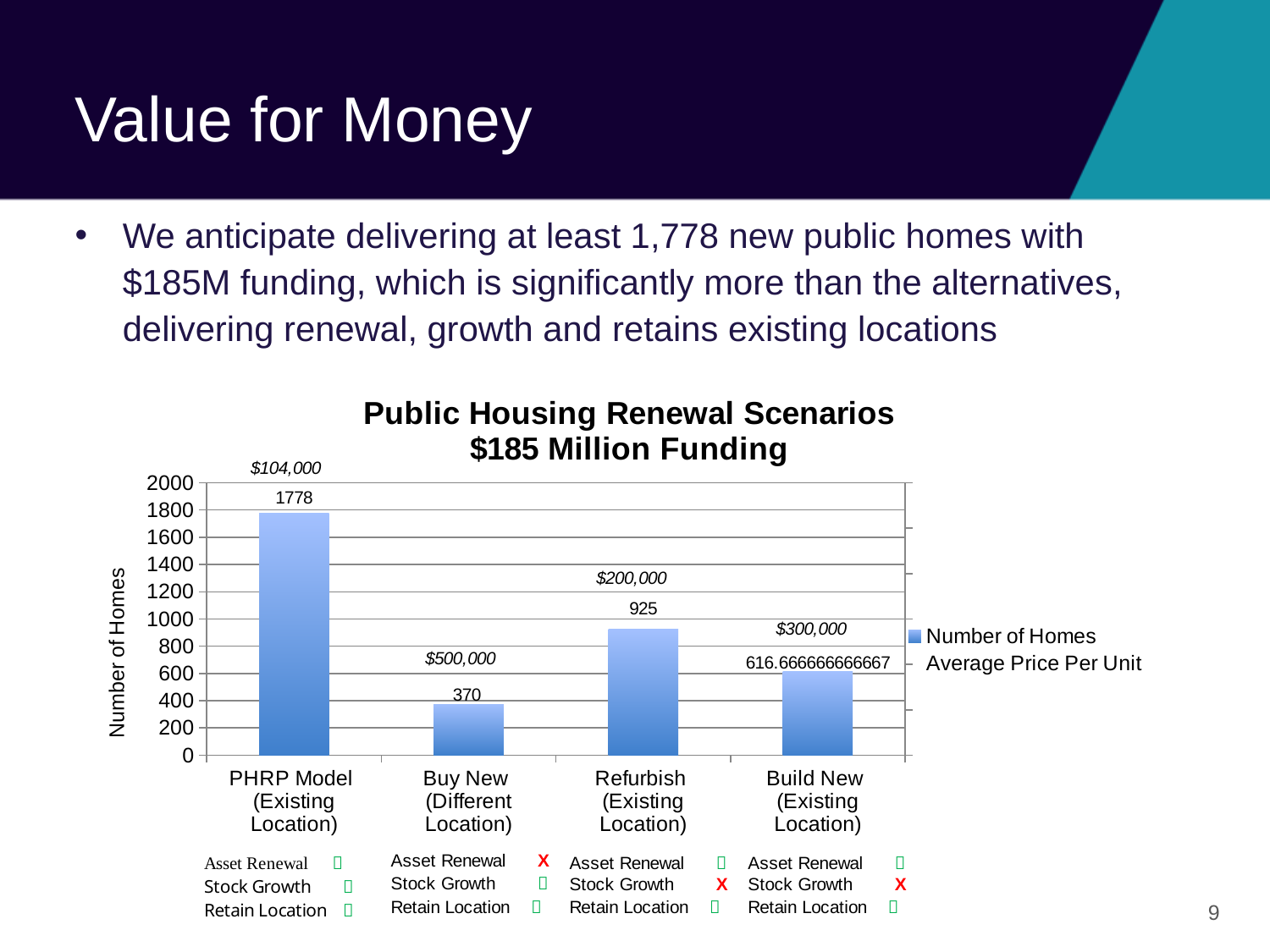
What is the difference in number of homes between the PHRP Model and Refurbish scenarios? 853 Which has more homes, Refurbish (Existing Location) or Buy New (Different Location)? Refurbish (Existing Location) Which scenario has the highest number of homes? PHRP Model (Existing Location) Which scenario has the lowest number of homes? Buy New (Different Location) What is the number of homes for the Refurbish (Existing Location) scenario? 925 What is the number of homes for the Buy New (Different Location) scenario? 370 How many series does the chart legend list? 2 What average price per unit is shown for the PHRP Model (Existing Location) scenario? $104,000 What is the number of homes for the PHRP Model (Existing Location) scenario? 1778 What type of chart is used to show the Public Housing Renewal Scenarios? Bar chart What average price per unit is shown for the Build New (Existing Location) scenario? $300,000 How many scenarios are shown on the x axis of the chart? 4